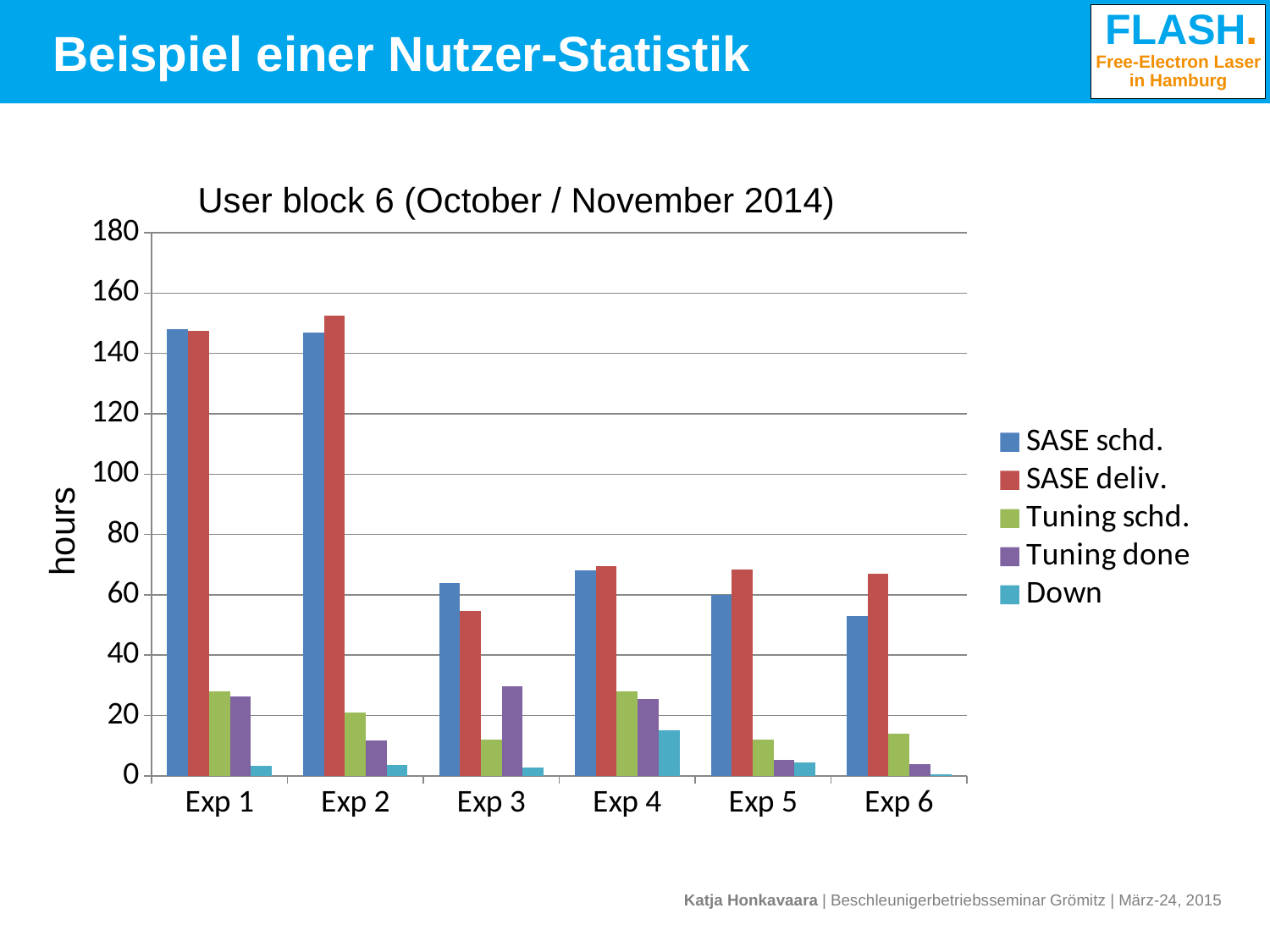
Which experiment has the highest SASE deliv. value? Exp 2 Which experiment has the highest Down value? Exp 4 For Exp 6, which is larger: SASE schd. or SASE deliv.? SASE deliv. Is the SASE deliv. value for Exp 3 greater or less than 60? less What is the label of the vertical axis? hours What kind of chart is shown on the slide? bar chart How many series does the legend list? 5 How many experiments (categories) are shown on the x axis? 6 Is the Tuning done value for Exp 3 greater or less than 20? greater What is the title of the chart? User block 6 (October / November 2014) Is the SASE schd. value for Exp 1 greater or less than 140? greater Which experiment has the lowest SASE schd. value? Exp 6